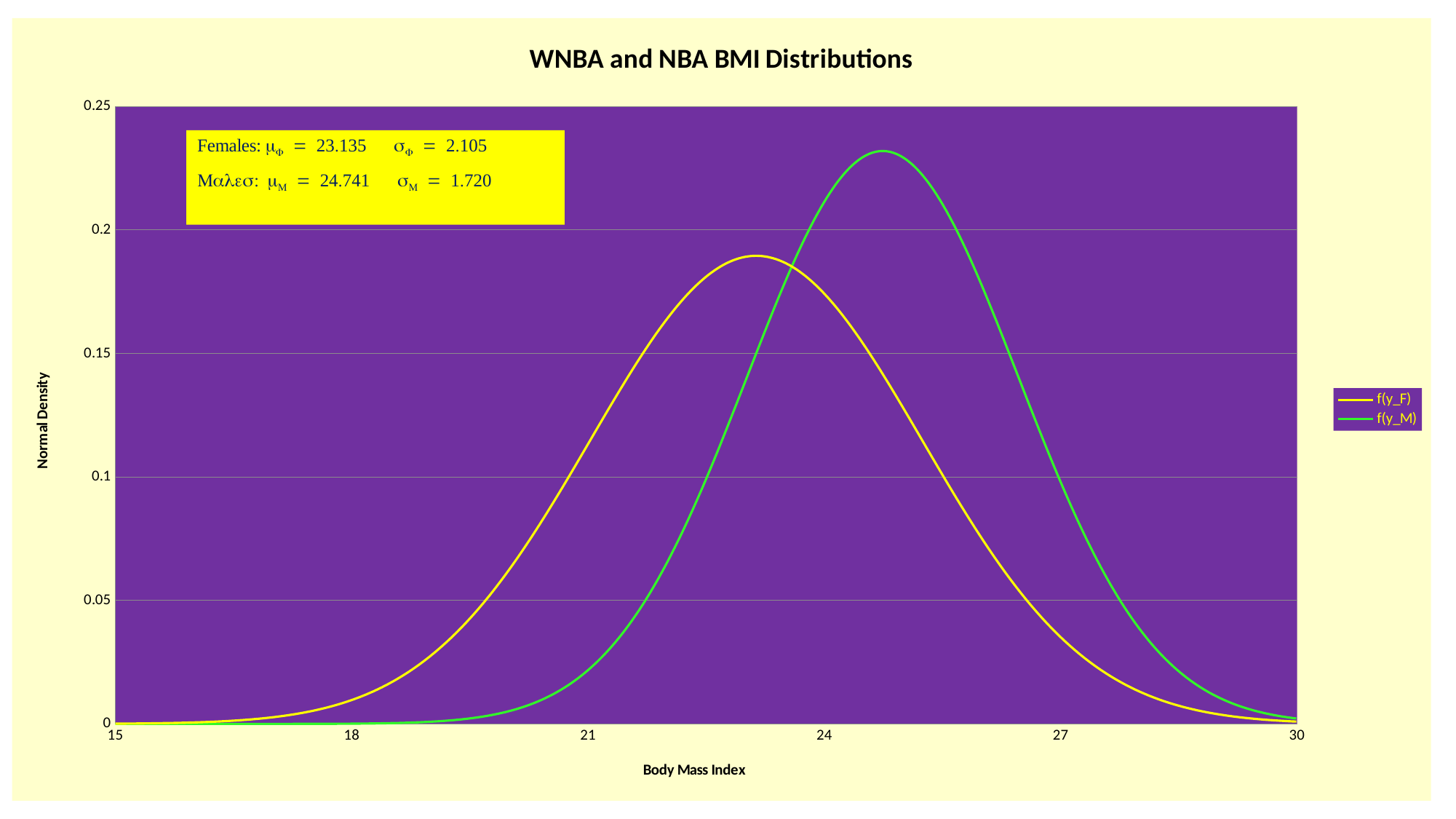
Is the value of f(y_M) at a Body Mass Index of 27 greater or less than 0.05? greater Is the value of f(y_F) at a Body Mass Index of 18 greater or less than 0.05? less Is the peak value of the f(y_F) curve greater or less than 0.2? less Which series reaches the higher peak density, f(y_F) or f(y_M)? f(y_M) How many series does the legend list? 2 Which curve peaks at a higher Body Mass Index, f(y_F) or f(y_M)? f(y_M) What colour is the f(y_M) line? green What kind of chart is shown on the slide? line chart According to the text box, what is the mean BMI for females? 23.135 According to the text box, what is the standard deviation of BMI for males? 1.720 What is the title of the chart? WNBA and NBA BMI Distributions